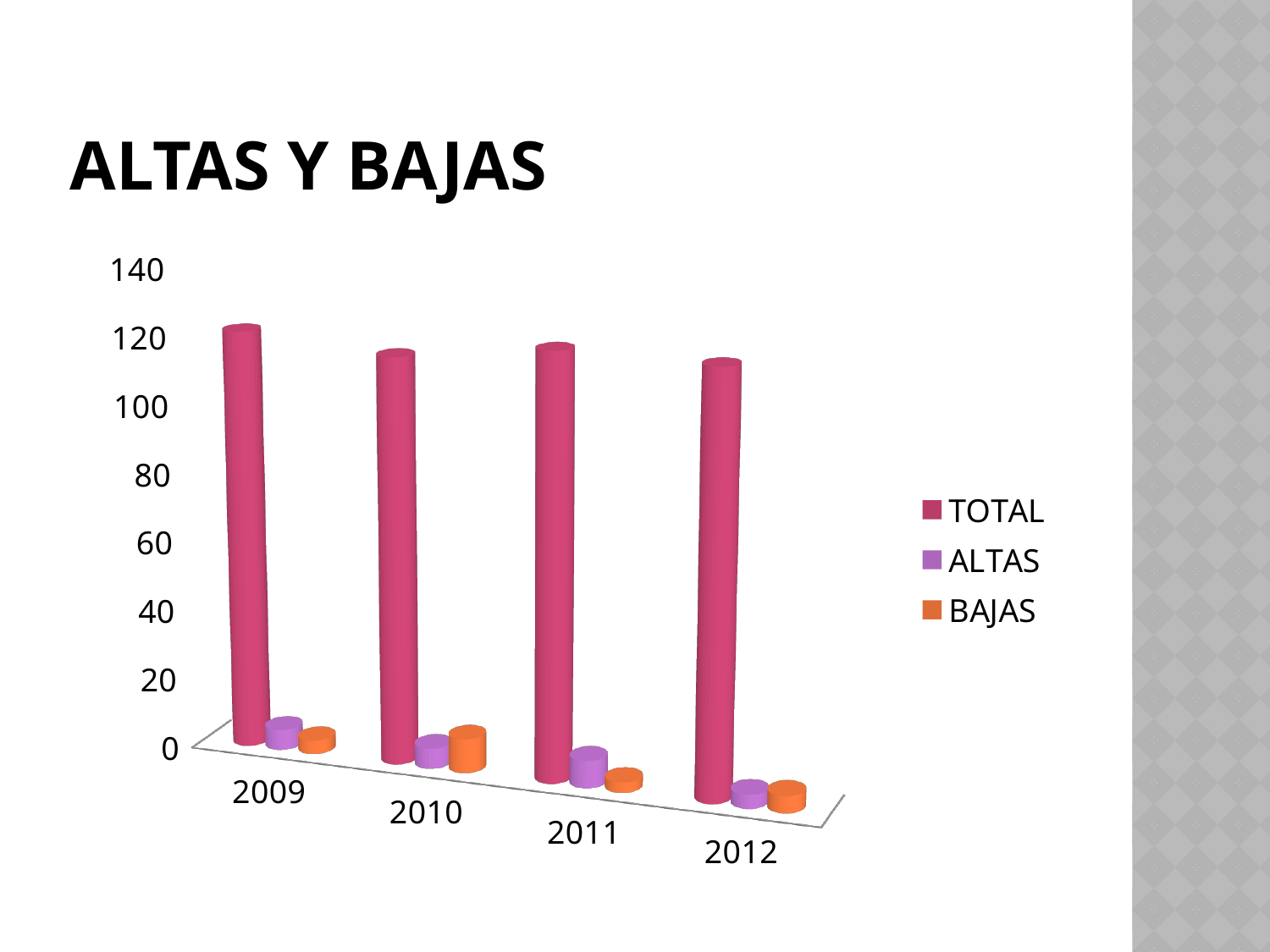
How many years are shown on the x axis of the chart? 4 What are the three series named in the legend? TOTAL, ALTAS, BAJAS Which year has the highest BAJAS value? 2010 Is the BAJAS value for 2010 greater or less than 40? less Is the ALTAS value for 2009 greater or less than 20? less Is the TOTAL value for 2009 greater or less than 100? greater What kind of chart is shown on the slide? bar chart What is the title of the slide containing the chart? ALTAS Y BAJAS How many series does the legend list? 3 In 2012, which is larger, TOTAL or BAJAS? TOTAL